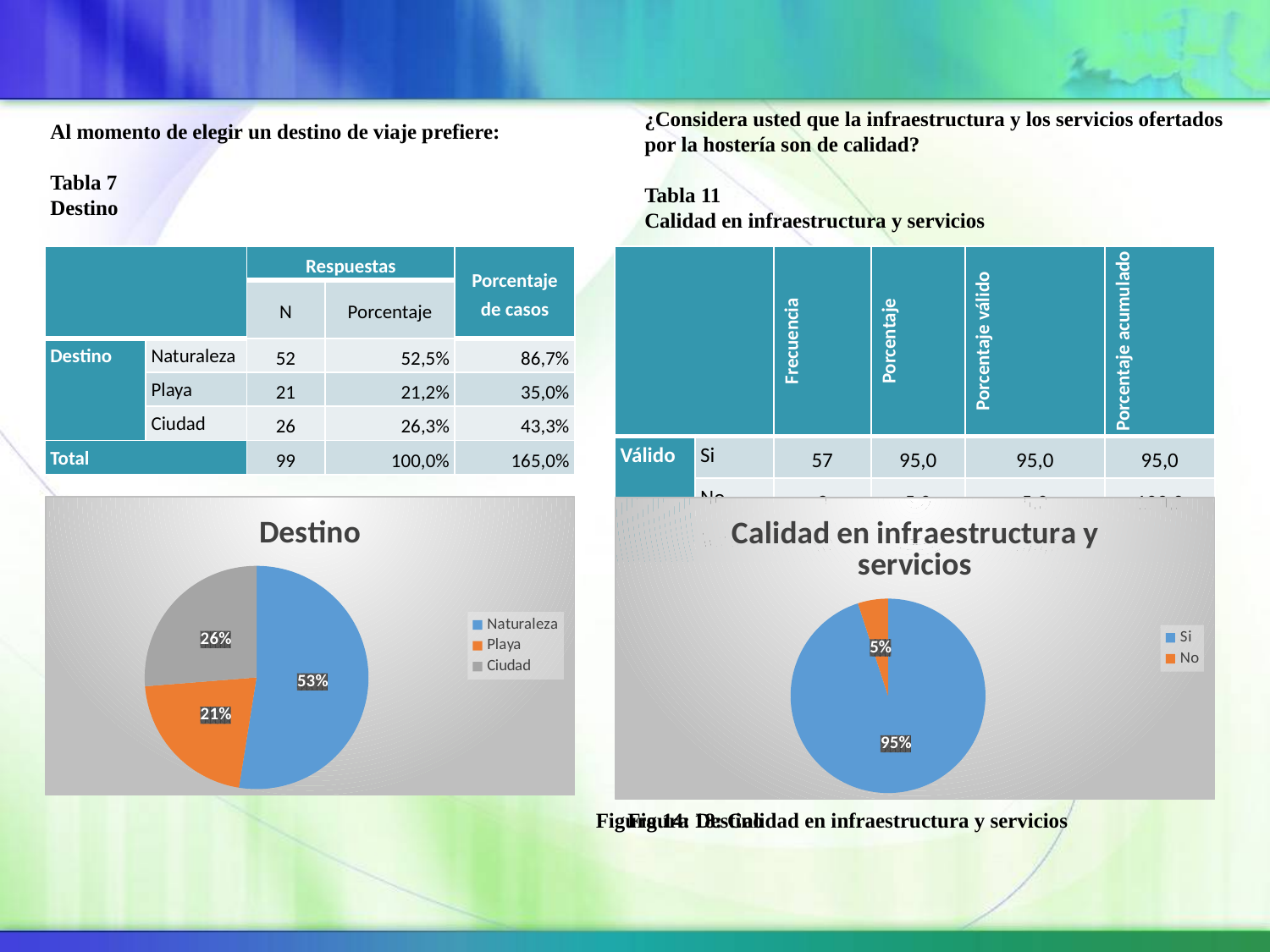
In the "Destino" chart, what share of the pie is Ciudad? 26% What kind of chart is the "Destino" chart? Pie chart In the "Calidad en infraestructura y servicios" chart, what colour is the Si slice? Blue In the "Calidad en infraestructura y servicios" chart, what share of the pie is No? 5% In the "Destino" chart, how many categories does the legend list? 3 In the "Destino" chart, which category has the largest slice? Naturaleza In the "Calidad en infraestructura y servicios" chart, what share of the pie is Si? 95% In the "Destino" chart, which category has the smallest slice? Playa In the "Destino" chart, what is the difference in percentage points between Naturaleza and Ciudad? 27 In the "Calidad en infraestructura y servicios" chart, which is larger, Si or No? Si